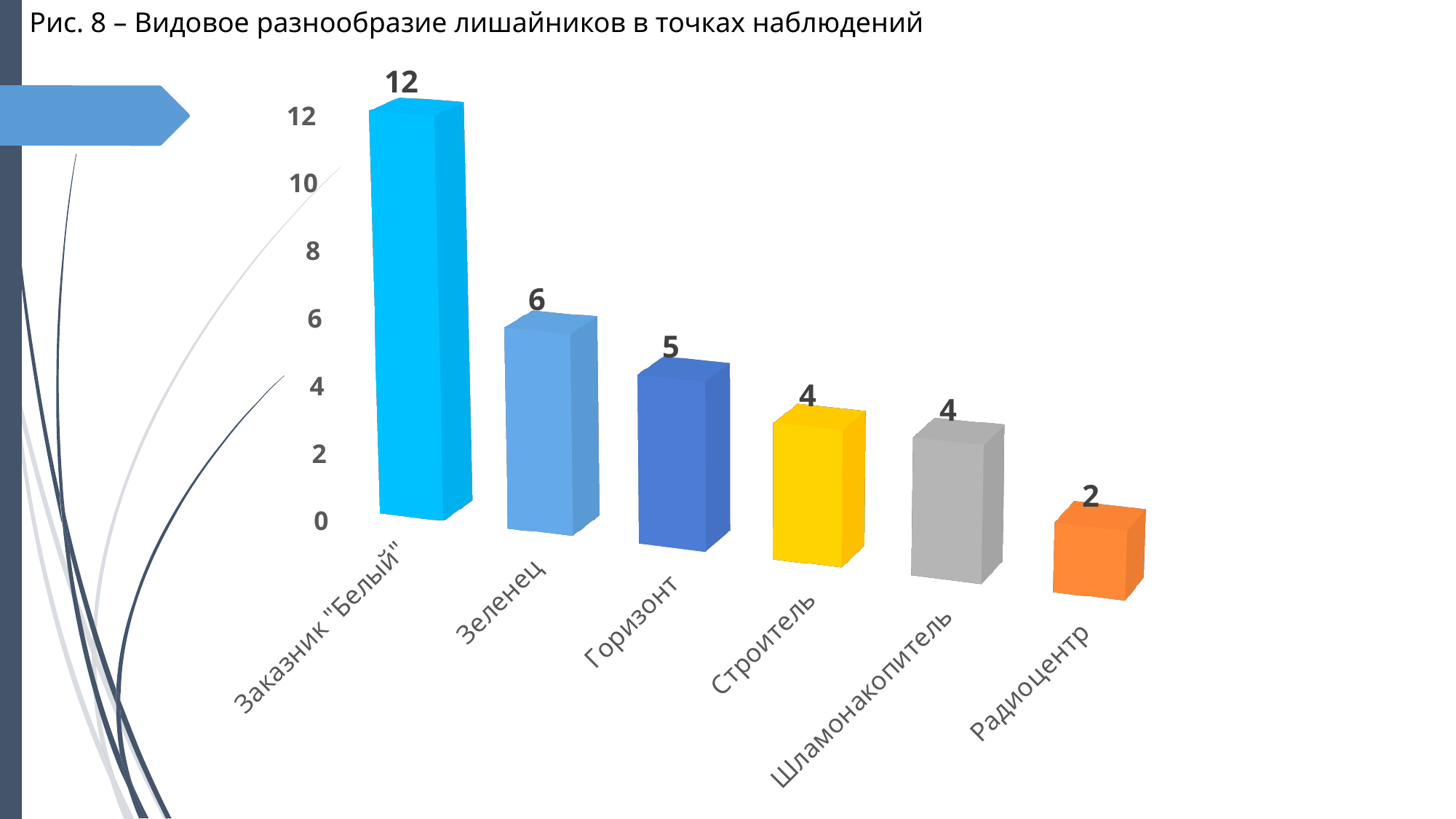
What is the difference between the values for Горизонт and Радиоцентр? 3 Which category has the highest value? Заказник "Белый" Which is larger, the value for Зеленец or the value for Строитель? Зеленец What is the value for Зеленец? 6 What is the value for Радиоцентр? 2 What kind of chart is shown on the slide? Bar chart Which category has the lowest value? Радиоцентр What is the value for Горизонт? 5 Do the values rise or fall from left to right along the x axis? Fall What is the difference between the values for Заказник "Белый" and Зеленец? 6 How many categories are shown on the chart? 6 What is the value for Заказник "Белый"? 12